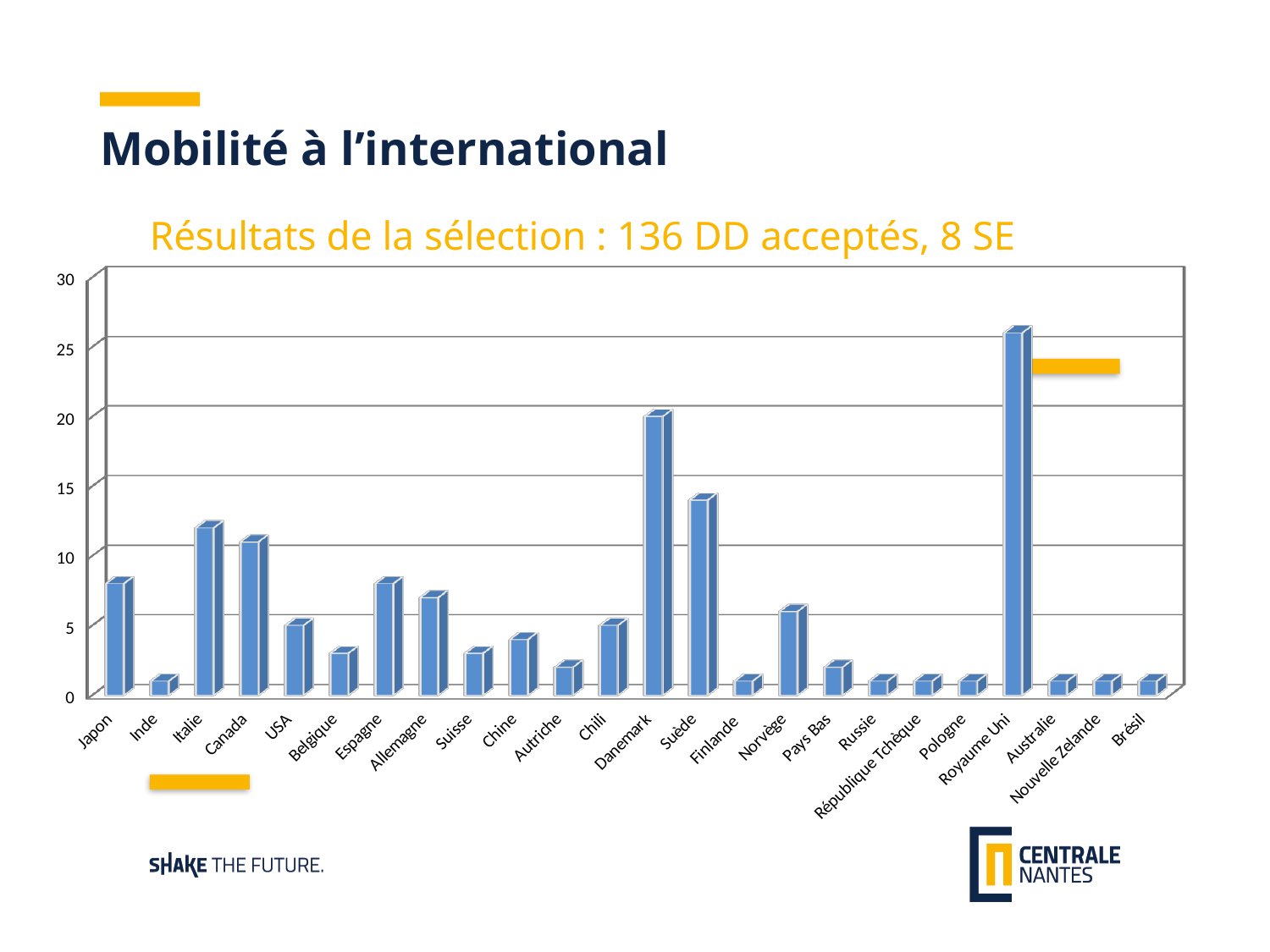
Which has the larger value, Danemark or Suède? Danemark What is the title shown above the chart? Résultats de la sélection : 136 DD acceptés, 8 SE Which has the larger value, USA or Belgique? USA Is the value for Inde greater or less than 5? less Is the value for Italie greater or less than 10? greater Is the value for Japon greater or less than 10? less How many countries are shown on the x axis of the chart? 24 Which country has the highest bar in the chart? Royaume Uni What kind of chart is shown on the slide? bar chart